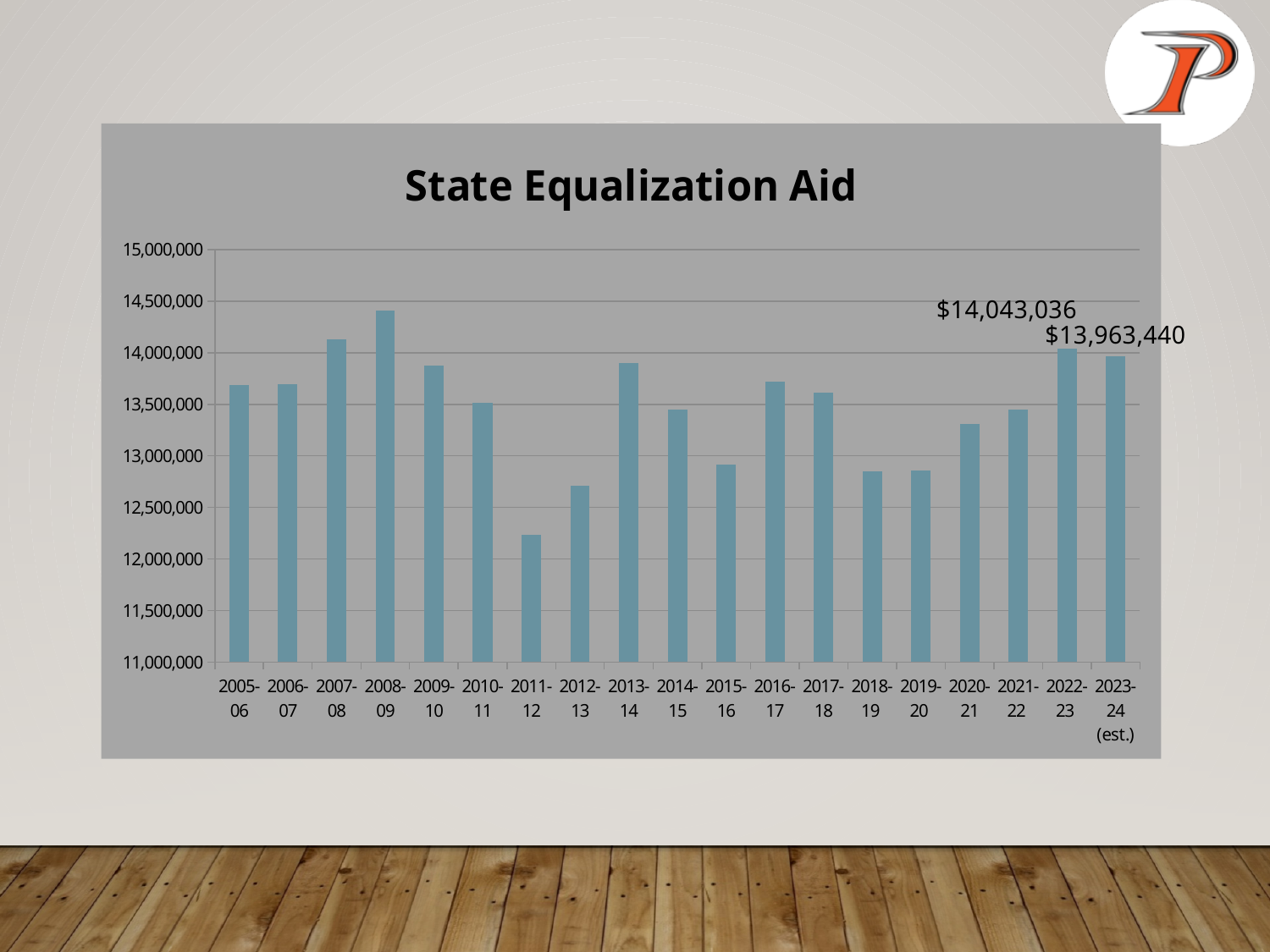
Is the value for 2011-12 greater or less than 12,500,000? less What is the value for 2023-24 (est.) in the State Equalization Aid chart? $13,963,440 Which year has the highest State Equalization Aid? 2008-09 Which year has the lowest State Equalization Aid? 2011-12 Which is larger, the value for 2007-08 or the value for 2012-13? 2007-08 Which is larger, the value for 2022-23 or the value for 2023-24 (est.)? 2022-23 What is the value for 2022-23 in the State Equalization Aid chart? $14,043,036 How many years are shown on the x axis of the chart? 19 What is the title of the chart? State Equalization Aid What is the difference between the 2022-23 value and the 2023-24 (est.) value? $79,596 Is the value for 2008-09 greater or less than 14,000,000? greater What kind of chart is shown on the slide? bar chart